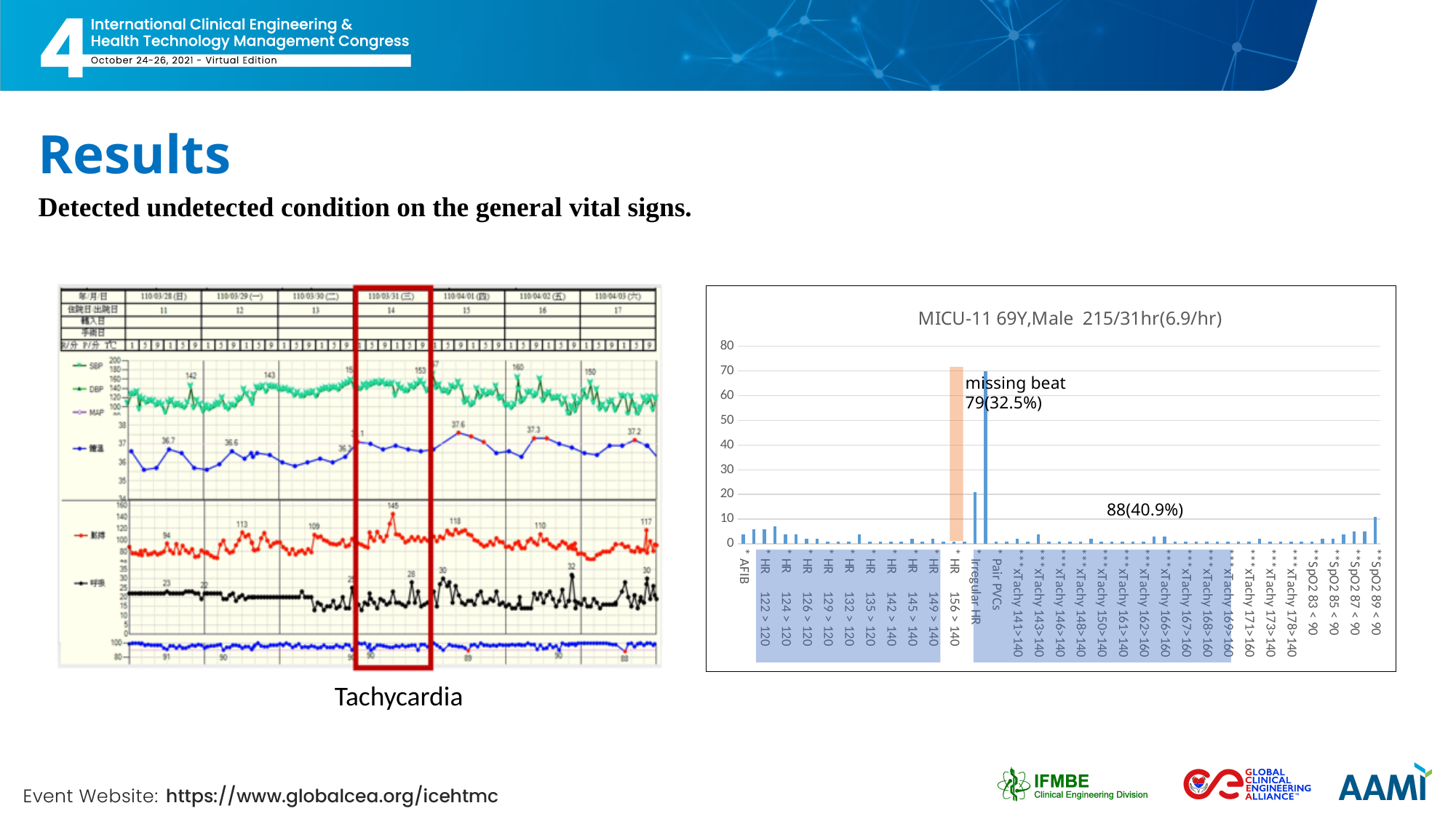
What caption is written below the vital signs image on the left of the slide? Tachycardia In the bar chart on the right, is the value for AFIB greater or less than 10? less What kind of chart is shown on the right side of the slide? bar chart What is the highest tick value shown on the vertical axis of the bar chart on the right? 80 In the bar chart on the right, is the value for Pair PVCs greater or less than 60? less What annotation text appears next to the highlighted HR 156 > 140 column in the bar chart on the right? missing beat 79(32.5%) In the bar chart on the right, which category has the highest bar? missing beat In the bar chart on the right, is the value for Irregular HR greater or less than 10? greater In the bar chart on the right, which is larger: the value for Irregular HR or the value for Pair PVCs? Irregular HR What is the title of the bar chart on the right? MICU-11 69Y,Male 215/31hr(6.9/hr) In the bar chart on the right, which is larger: the value for SpO2 89 < 90 or the value for SpO2 83 < 90? SpO2 89 < 90